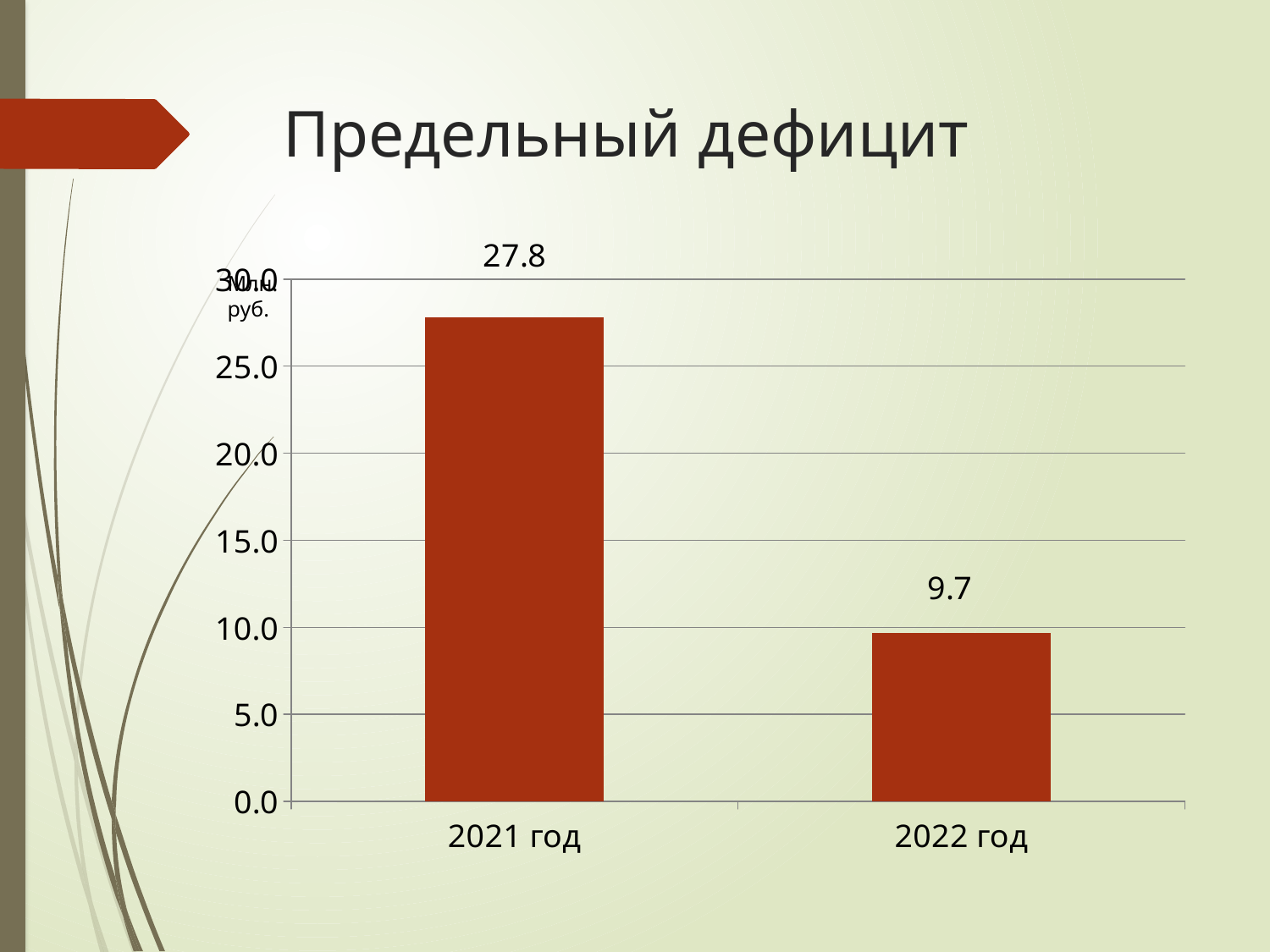
What is the value for 2021 год? 27.8 Do the values rise or fall from 2021 год to 2022 год? fall Is the value for 2022 год greater or less than 10.0? less What is the value for 2022 год? 9.7 What kind of chart is shown on the slide? bar chart Which year has the highest value? 2021 год Is the value for 2021 год greater or less than 25.0? greater What is the difference between the values for 2021 год and 2022 год? 18.1 What is the title of the slide? Предельный дефицит Which year has the lowest value? 2022 год Which is larger, the value for 2021 год or for 2022 год? 2021 год How many categories are shown on the x axis? 2